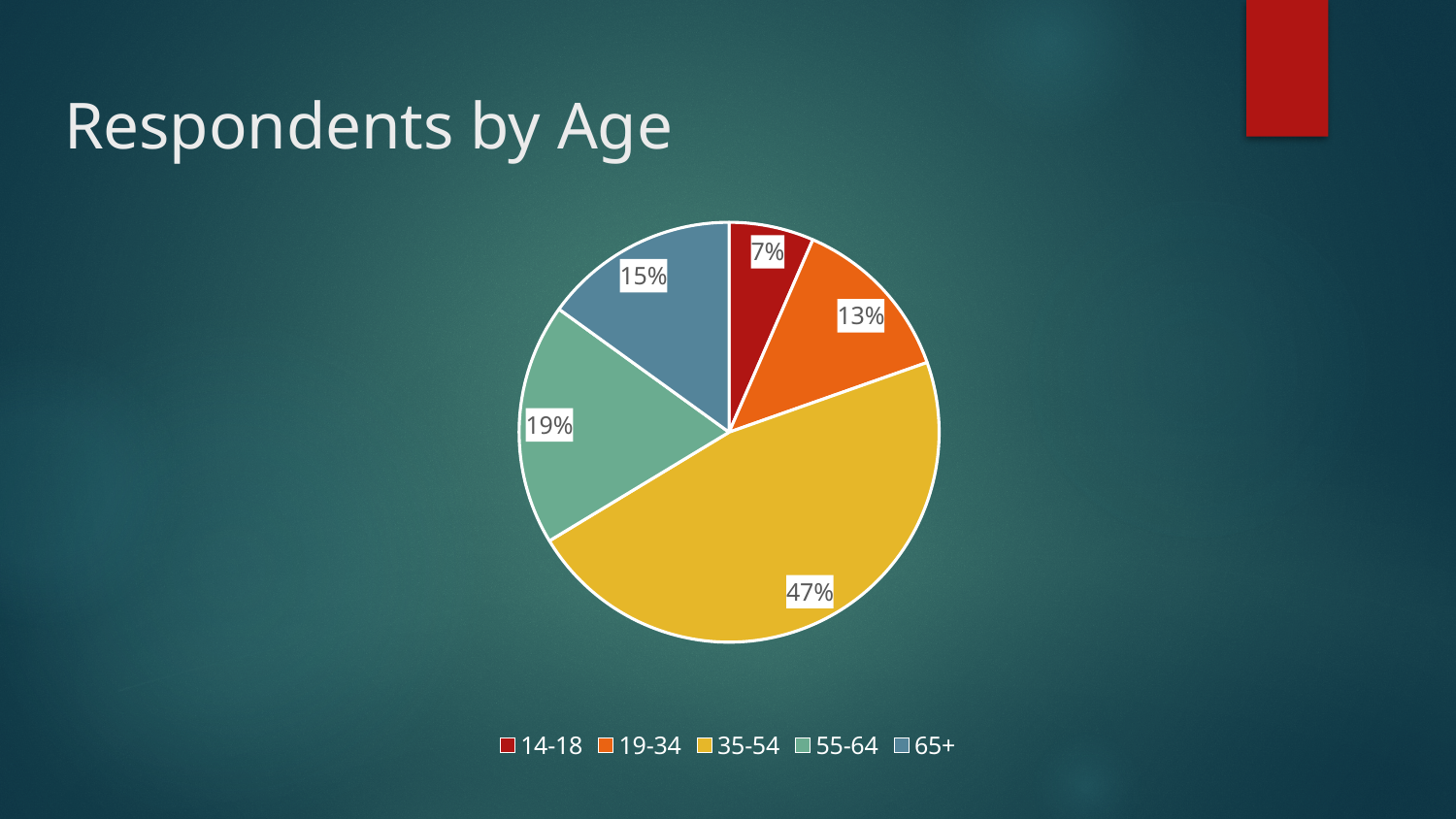
What kind of chart is shown on the slide? Pie chart What share of respondents are aged 35-54? 47% Which age group has the smallest share of respondents? 14-18 What share of respondents are aged 19-34? 13% What is the title of the slide? Respondents by Age What share of respondents are aged 55-64? 19% How many age groups are shown in the pie chart? 5 What is the difference in percentage points between the 35-54 and 55-64 age groups? 28 What share of respondents are aged 14-18? 7% Which age group has the largest share of respondents? 35-54 Which age group has a larger share, 55-64 or 65+? 55-64 What share of respondents are aged 65+? 15%